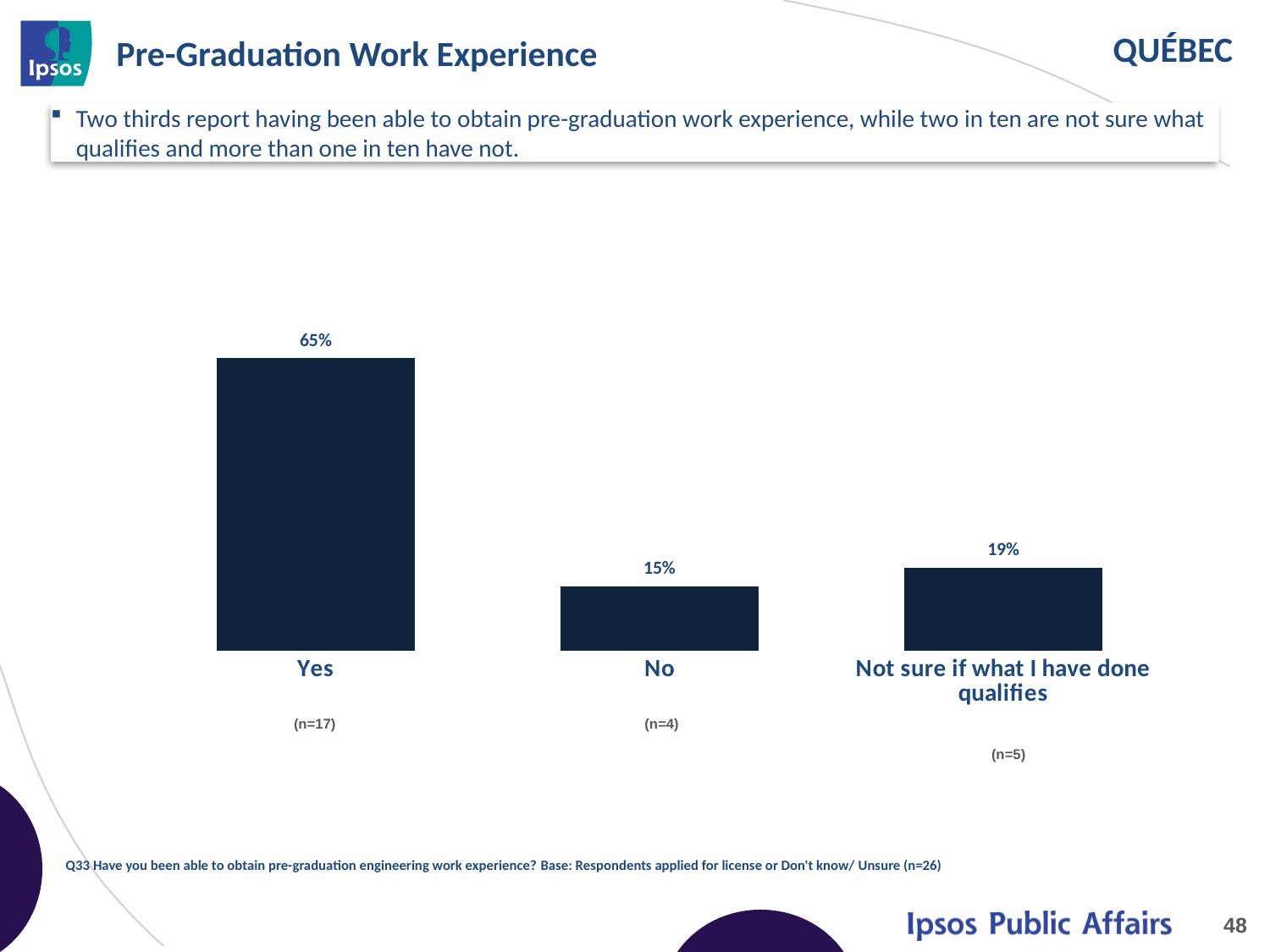
Which is larger, the percentage for "No" or for "Not sure if what I have done qualifies"? Not sure if what I have done qualifies What percentage of respondents answered "Not sure if what I have done qualifies"? 19% What is the difference in percentage points between "Not sure if what I have done qualifies" and "No"? 4 Which response category has the highest percentage? Yes What is the difference in percentage points between "Yes" and "No"? 50 What is the sample size (n) shown for the "Yes" category? (n=17) What percentage of respondents answered "No"? 15% Which response category has the lowest percentage? No How many response categories are shown in the chart? 3 What type of chart is shown on the slide? Bar chart What is the title of the slide containing the chart? Pre-Graduation Work Experience What percentage of respondents answered "Yes"? 65%